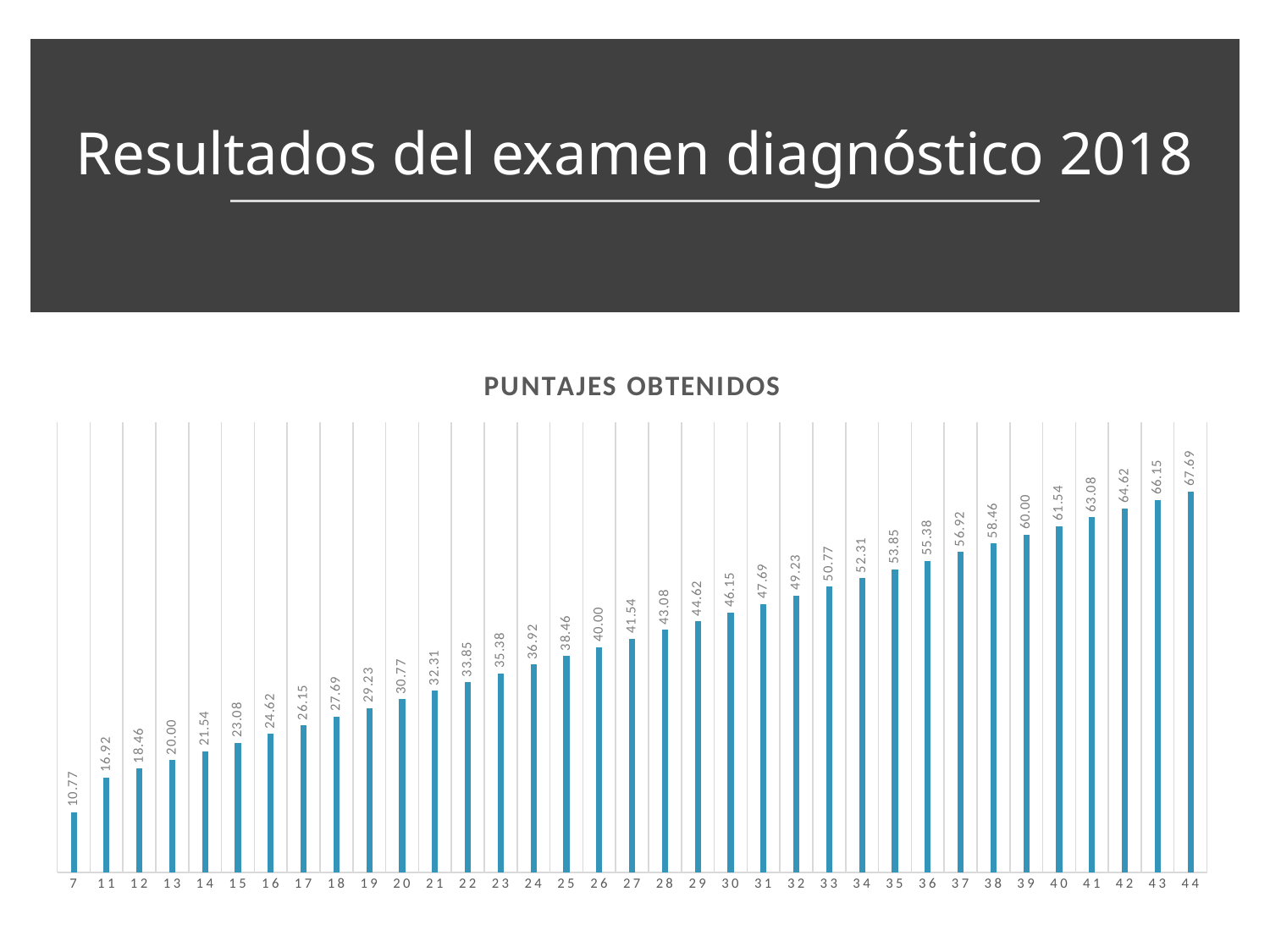
Do the values rise or fall from left to right along the x axis? Rise What is the difference between the values for category 20 and category 13? 10.77 Which is larger, the value for category 30 or the value for category 22? 30 How many bars are plotted in the chart? 35 Which category has the lowest value in the chart? 7 What kind of chart is shown on the slide? Bar chart What is the value for category 26 in the chart? 40.00 What is the value for category 39 in the chart? 60.00 What is the value for category 33 in the chart? 50.77 Which category has the highest value in the chart? 44 What is the difference between the values for category 44 and category 7? 56.92 What is the value for category 7 in the chart? 10.77